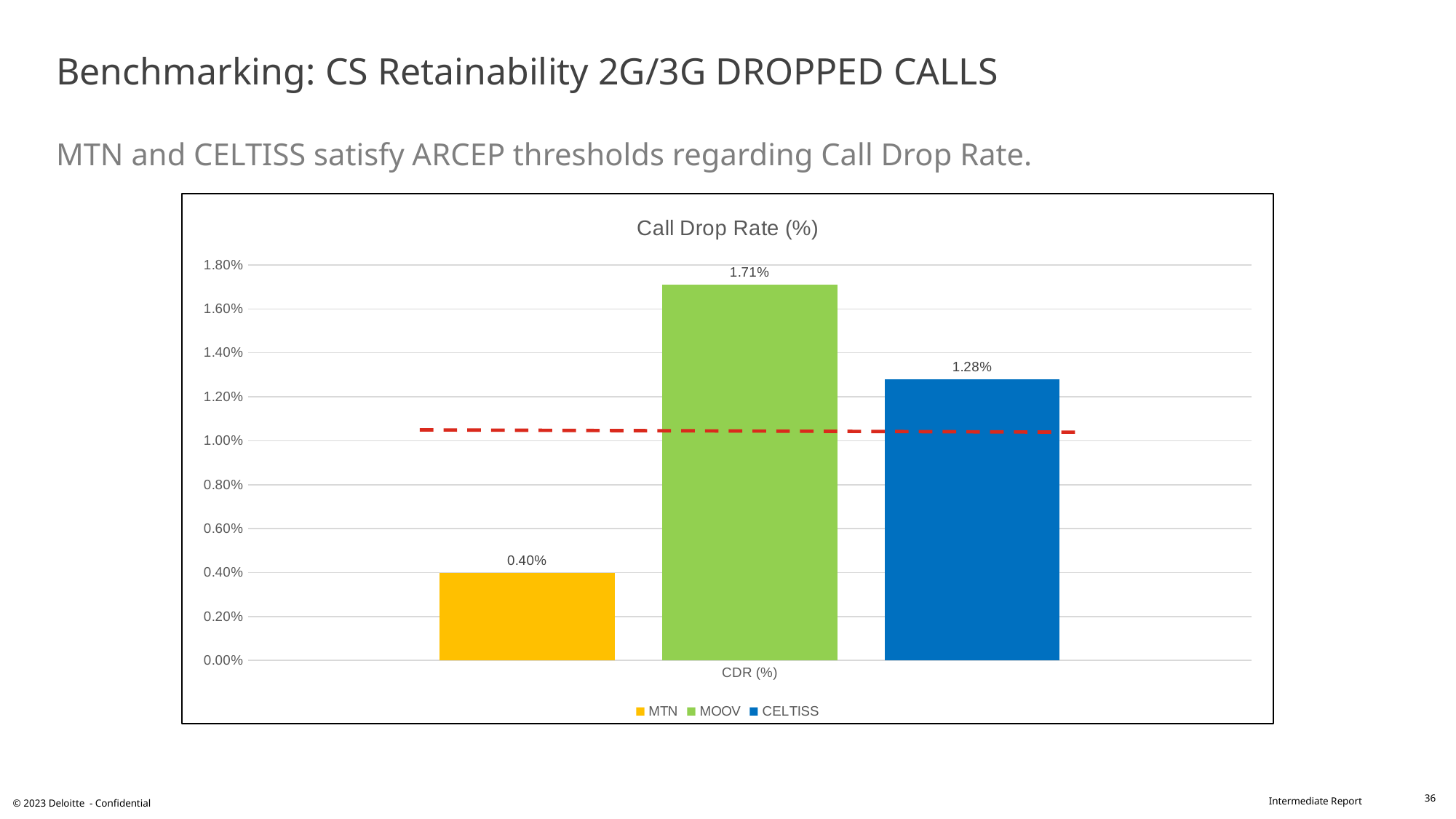
What is the Call Drop Rate for MOOV? 1.71% Which operator has the highest Call Drop Rate? MOOV Is the Call Drop Rate for CELTISS greater or less than 1.00%? greater Which has a higher Call Drop Rate, CELTISS or MOOV? MOOV What is the difference between the Call Drop Rate of CELTISS and MTN? 0.88% Which operator has the lowest Call Drop Rate? MTN What is the Call Drop Rate for CELTISS? 1.28% What is the Call Drop Rate for MTN? 0.40% What is the title of the chart? Call Drop Rate (%) What is the difference between the Call Drop Rate of MOOV and MTN? 1.31% What kind of chart is shown on the slide? Bar chart How many series does the legend list? 3